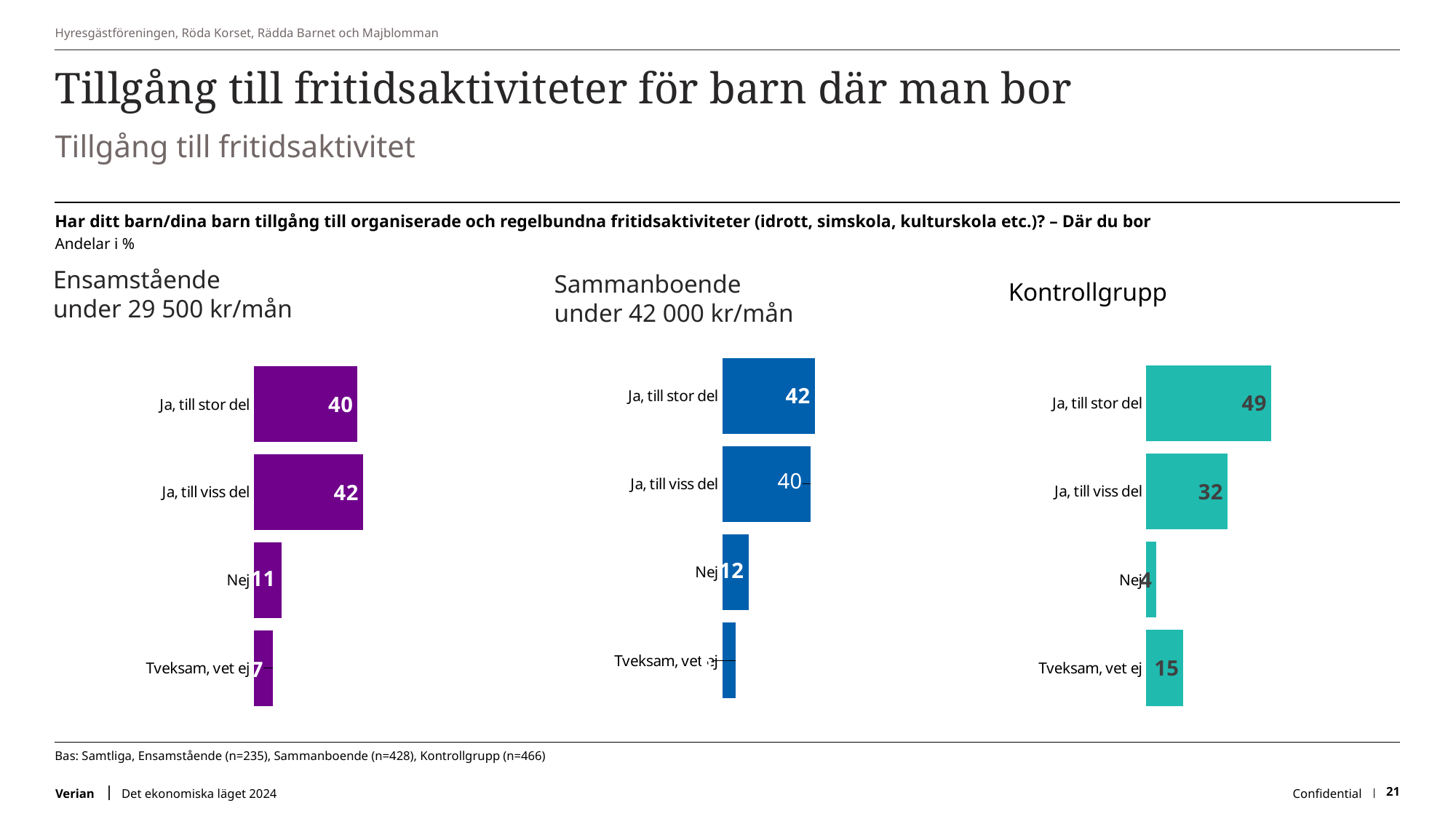
In the Sammanboende under 42 000 kr/mån chart, what is the difference between 'Ja, till stor del' and 'Nej'? 30 In the Kontrollgrupp chart, what is the value for 'Tveksam, vet ej'? 15 In the Ensamstående under 29 500 kr/mån chart, which category has the lowest value? Tveksam, vet ej In the Kontrollgrupp chart, what is the difference between 'Ja, till stor del' and 'Ja, till viss del'? 17 How many categories does the Kontrollgrupp chart show? 4 What type of chart is the Ensamstående under 29 500 kr/mån chart? Bar chart Which is larger: 'Ja, till stor del' in the Ensamstående chart or 'Ja, till stor del' in the Kontrollgrupp chart? Kontrollgrupp In the Kontrollgrupp chart, which category has the lowest value? Nej In the Ensamstående under 29 500 kr/mån chart, what is the value for 'Nej'? 11 In the Kontrollgrupp chart, which category has the highest value? Ja, till stor del In the Ensamstående under 29 500 kr/mån chart, what is the value for 'Ja, till stor del'? 40 In the Sammanboende under 42 000 kr/mån chart, what is the value for 'Ja, till viss del'? 40